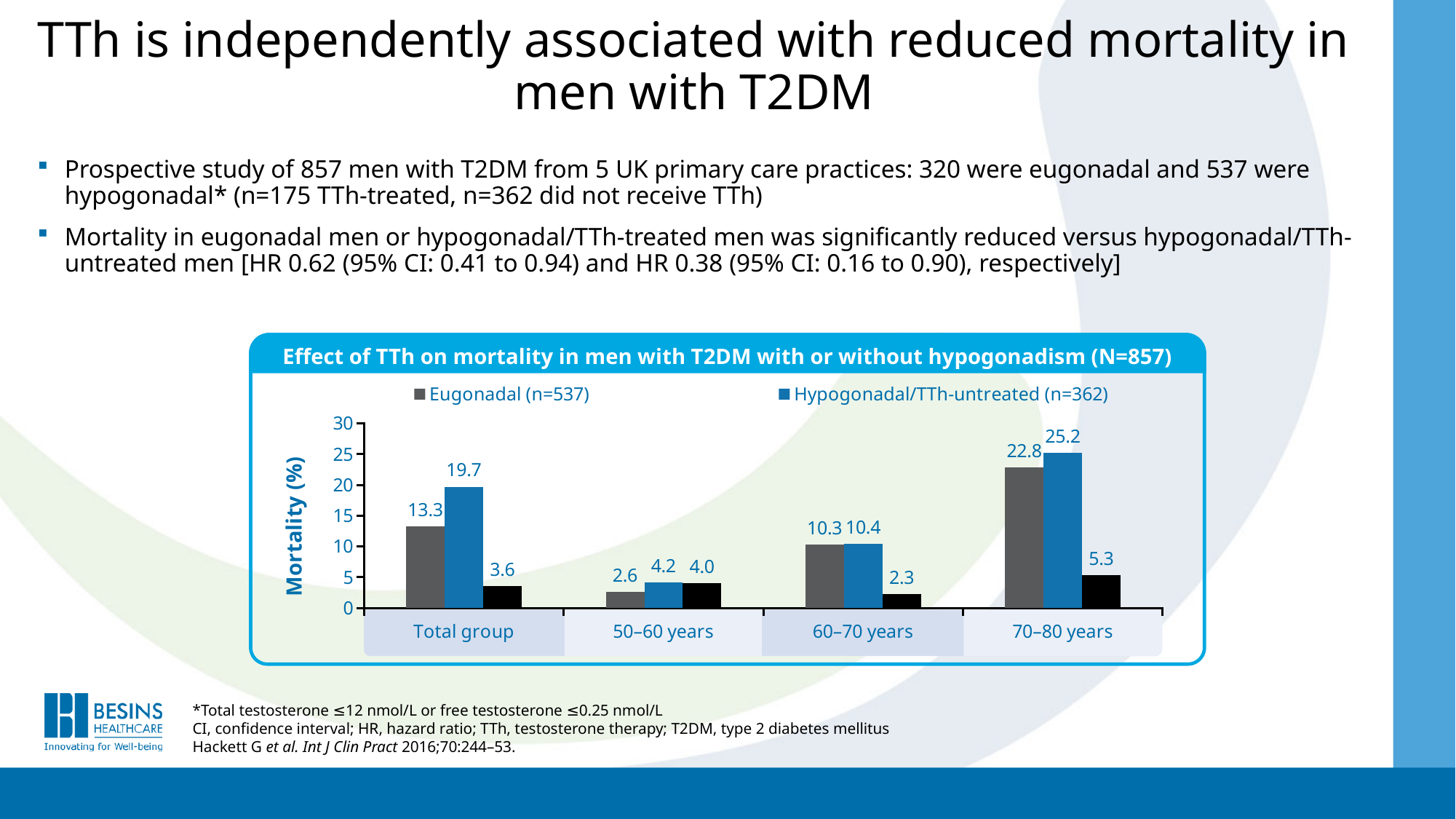
In which category is the Eugonadal (n=537) mortality lowest? 50–60 years How many categories are shown on the x axis of the chart? 4 What is the mortality value for the Hypogonadal/TTh-untreated (n=362) series in the 70–80 years group? 25.2 In the 70–80 years group, which series has the higher mortality: Eugonadal (n=537) or Hypogonadal/TTh-untreated (n=362)? Hypogonadal/TTh-untreated (n=362) What type of chart is shown on the slide? Bar chart What is the mortality value for the Eugonadal (n=537) series in the Total group? 13.3 Does the Eugonadal (n=537) mortality rise or fall across the age groups from 50–60 years to 70–80 years? Rise In the Total group, how much higher is the Hypogonadal/TTh-untreated (n=362) mortality than the Eugonadal (n=537) mortality? 6.4 How many series does the chart's legend list? 2 In which category is the Hypogonadal/TTh-untreated (n=362) mortality highest? 70–80 years What is the mortality value for the Eugonadal (n=537) series in the 60–70 years group? 10.3 What is the title of the chart's y axis? Mortality (%)